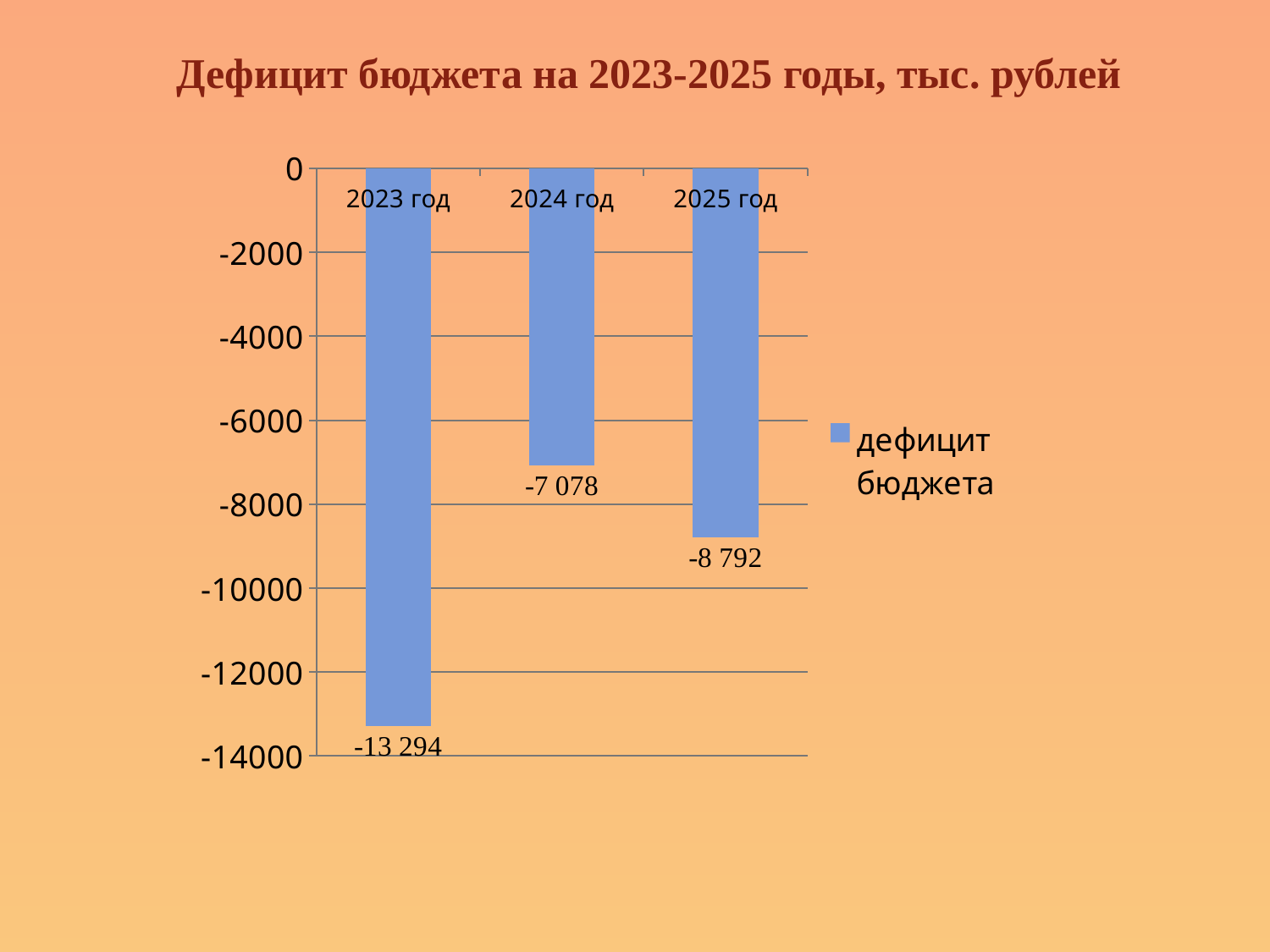
Which bar extends further below zero, 2024 год or 2025 год? 2025 год What is the difference between the values for 2025 год and 2024 год? 1 714 Which year has the highest (least negative) value? 2024 год What is the value for 2023 год? -13 294 How many years are shown on the chart? 3 How many series does the legend list? 1 What is the value for 2025 год? -8 792 What is the title of the chart? Дефицит бюджета на 2023-2025 годы, тыс. рублей What is the difference between the values for 2023 год and 2024 год? 6 216 Which year has the lowest (most negative) value? 2023 год What kind of chart is shown on the slide? bar chart What is the value for 2024 год? -7 078